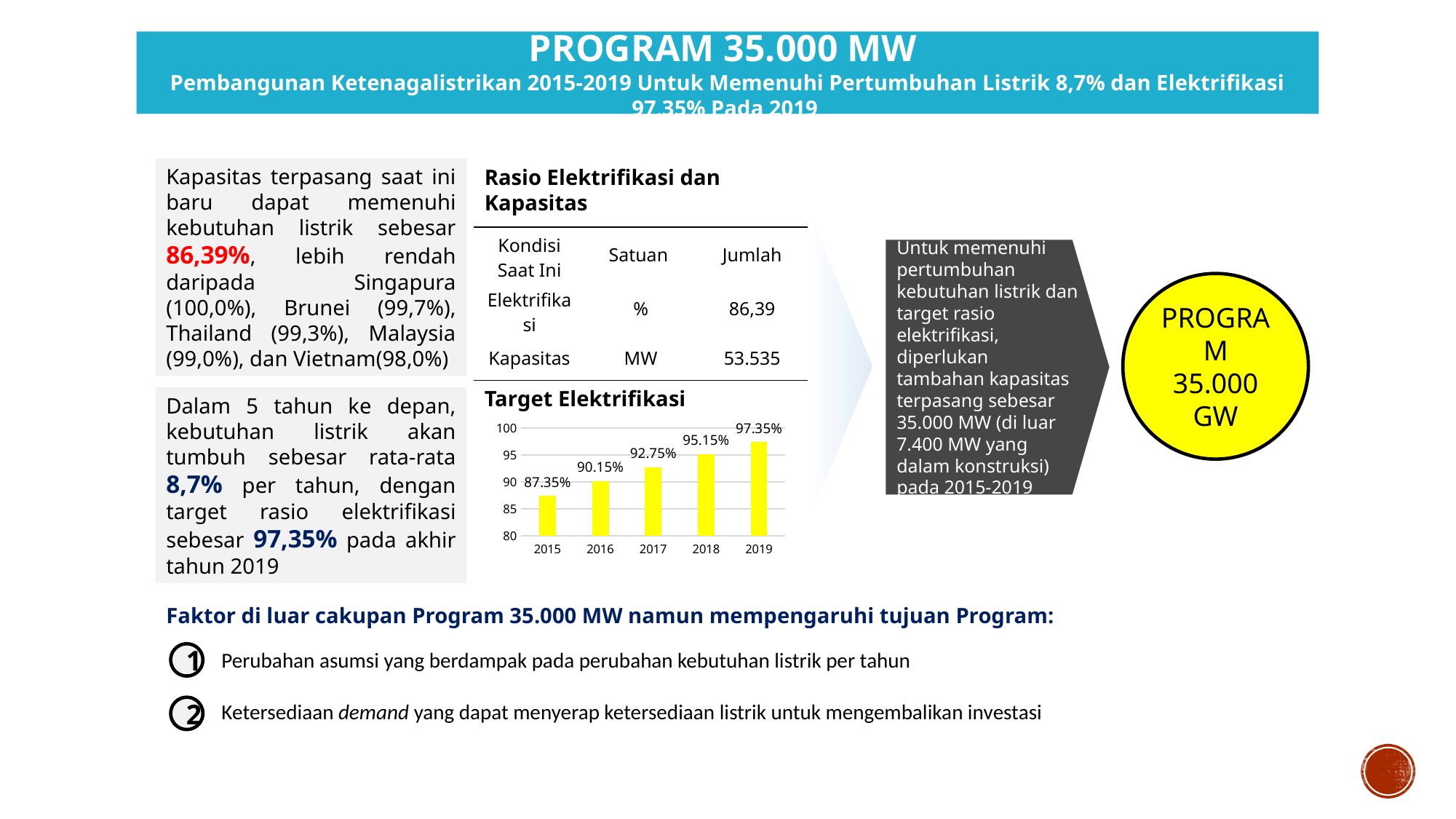
In the Target Elektrifikasi chart, which is larger, the value for 2016 or the value for 2018? 2018 Which year has the highest value in the Target Elektrifikasi chart? 2019 Which year has the lowest value in the Target Elektrifikasi chart? 2015 What is the target electrification value for 2015 in the Target Elektrifikasi chart? 87.35% What kind of chart is the Target Elektrifikasi chart? Bar chart How many years are shown on the x axis of the Target Elektrifikasi chart? 5 What is the difference between the 2019 and 2015 values in the Target Elektrifikasi chart? 10 percentage points What is the difference between the 2018 and 2016 values in the Target Elektrifikasi chart? 5 percentage points What is the target electrification value for 2017 in the Target Elektrifikasi chart? 92.75% In the Target Elektrifikasi chart, is the value for 2017 greater or less than 90? greater What is the target electrification value for 2019 in the Target Elektrifikasi chart? 97.35% Do the values in the Target Elektrifikasi chart rise or fall from 2015 to 2019? Rise